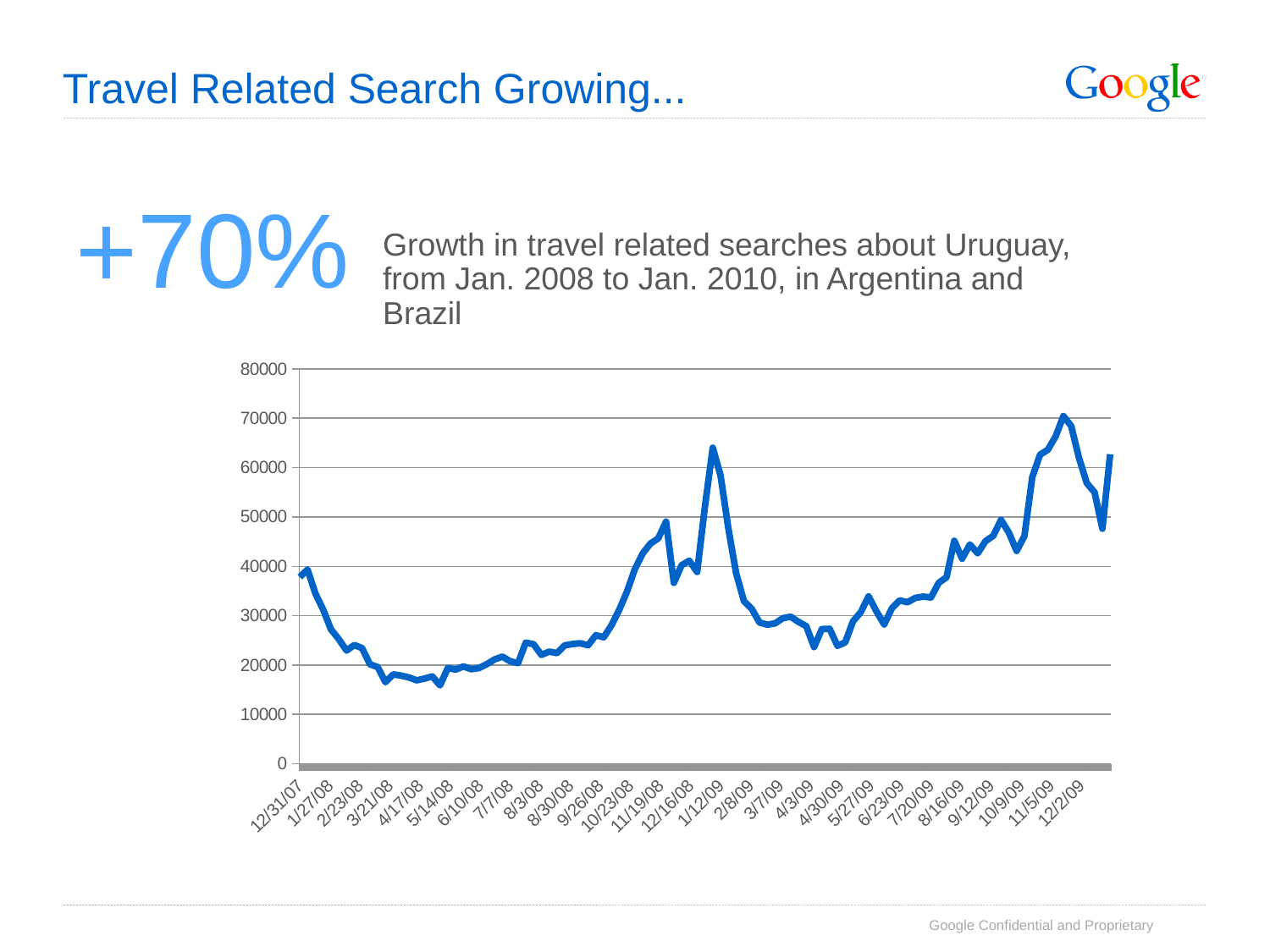
Is the value at 12/31/07 greater or less than 30000? greater What kind of chart is shown on the slide? line chart Comparing the start of the series (12/31/07) with the end (after 12/2/09), does the value rise or fall overall? rise Is the value at 8/16/09 greater or less than 40000? greater Around which x-axis date does the line reach its highest point? 11/5/09 Is the value at 4/3/09 greater or less than 30000? less What is the highest value shown on the y axis of the chart? 80000 Which is higher: the peak near 11/5/09 or the peak near 1/12/09? the peak near 11/5/09 What colour is the line plotted in the chart? blue